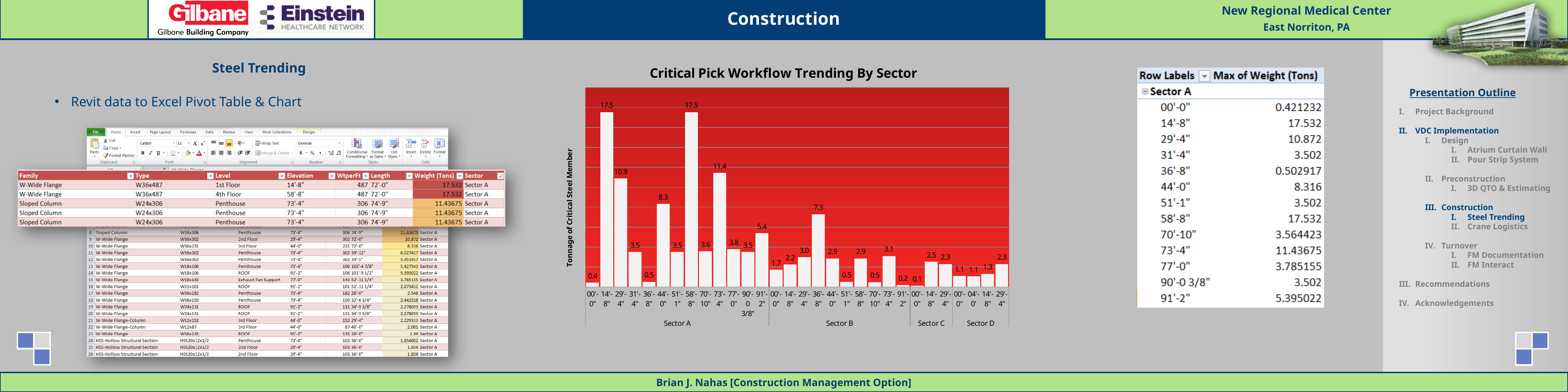
What is the value for 14'-8" in Sector A on the Critical Pick Workflow chart? 17.5 What is the highest value shown on the Critical Pick Workflow chart? 17.5 What type of chart is 'Critical Pick Workflow Trending By Sector'? Bar chart What is the value for 14'-8" in Sector C on the Critical Pick Workflow chart? 2.5 What is the value for 36'-8" in Sector B on the Critical Pick Workflow chart? 7.3 Which bar has the lowest value on the Critical Pick Workflow chart? 00'-0" in Sector C (0.1) What is the difference between the values for 29'-4" and 44'-0" in Sector A on the Critical Pick Workflow chart? 2.6 Which is larger on the Critical Pick Workflow chart: 36'-8" in Sector B or 91'-2" in Sector A? 36'-8" in Sector B What is the value for 73'-4" in Sector A on the Critical Pick Workflow chart? 11.4 How many sectors are shown along the x axis of the Critical Pick Workflow chart? 4 How many bars are plotted for Sector D on the Critical Pick Workflow chart? 4 What is the y-axis label of the Critical Pick Workflow chart? Tonnage of Critical Steel Member